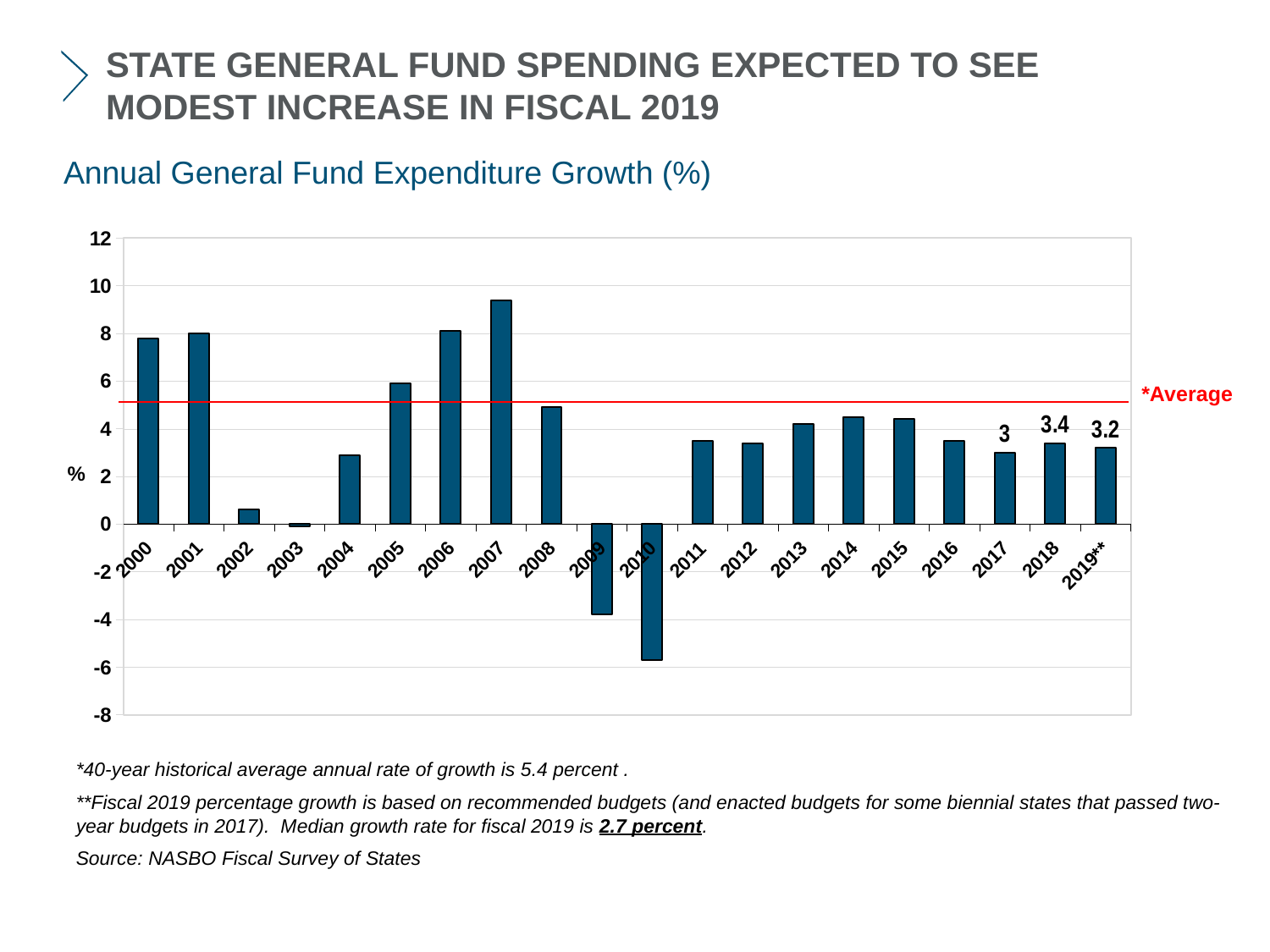
Is the value for 2009 greater or less than -2? less What is the value for 2017? 3 Is the value for 2006 greater or less than 6? greater What kind of chart is shown on the slide? bar chart What is the value for 2019**? 3.2 Which year has the lowest general fund expenditure growth? 2010 How many years are shown on the x axis? 20 Which is larger, the value for 2018 or the value for 2019**? 2018 What does the red horizontal line on the chart represent? *Average Which year has the highest general fund expenditure growth? 2007 What is the value for 2018? 3.4 What is the difference between the values for 2018 and 2017? 0.4